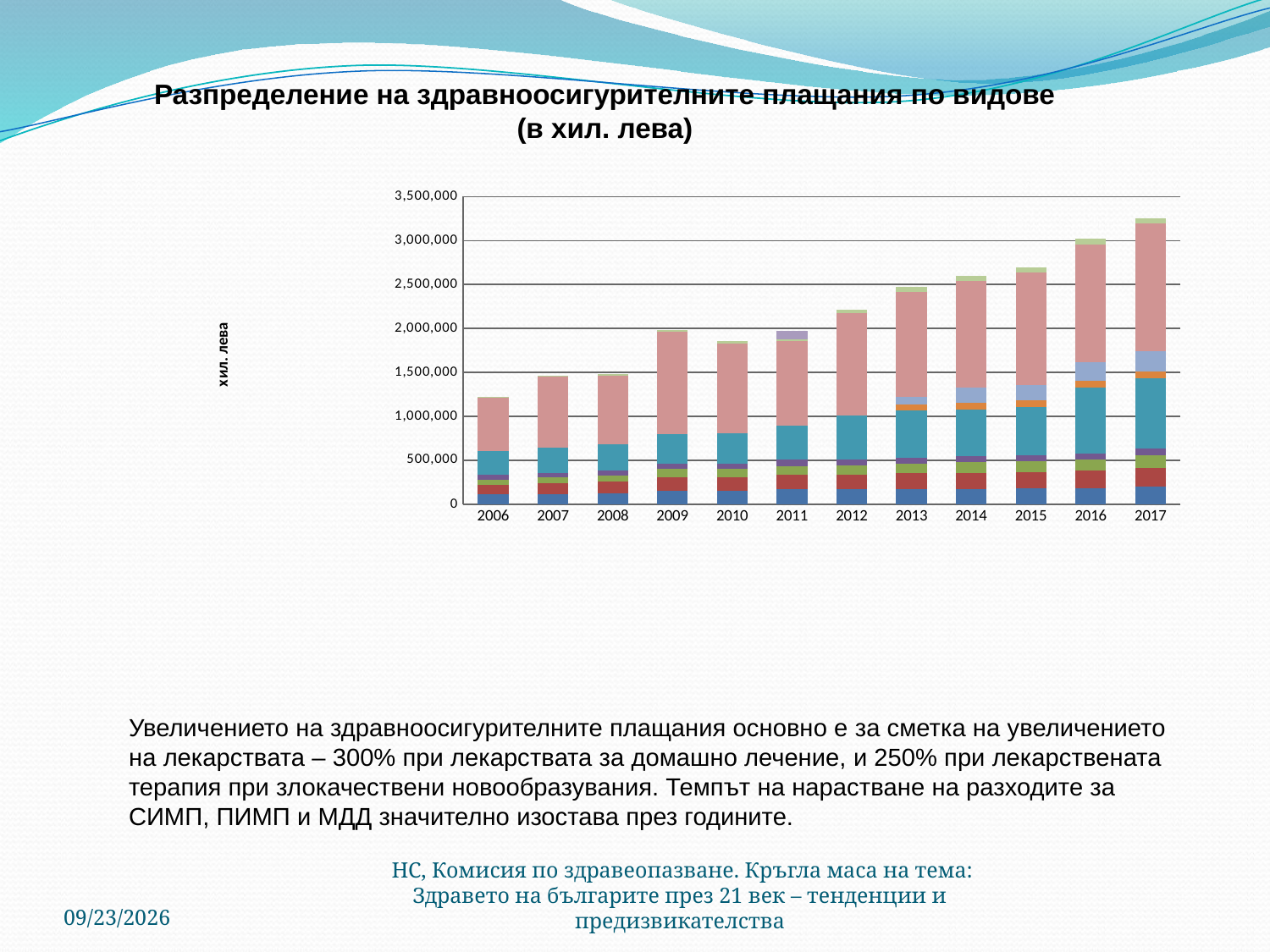
Which year has the tallest stacked bar in the chart? 2017 How many years are shown along the x axis of the chart? 12 Is the total bar height for 2012 greater or less than 2,000,000? greater Is the total bar height for 2017 greater or less than 3,000,000? greater What is the title of the chart on the slide? Разпределение на здравноосигурителните плащания по видове (в хил. лева) Do the total bar heights generally rise or fall from 2006 to 2017? Rise Which year has a taller stacked bar, 2012 or 2010? 2012 Is the total bar height for 2010 greater or less than 2,000,000? less What kind of chart is shown on the slide? Stacked bar chart What is the label on the vertical axis of the chart? хил. лева Which year has the shortest stacked bar in the chart? 2006